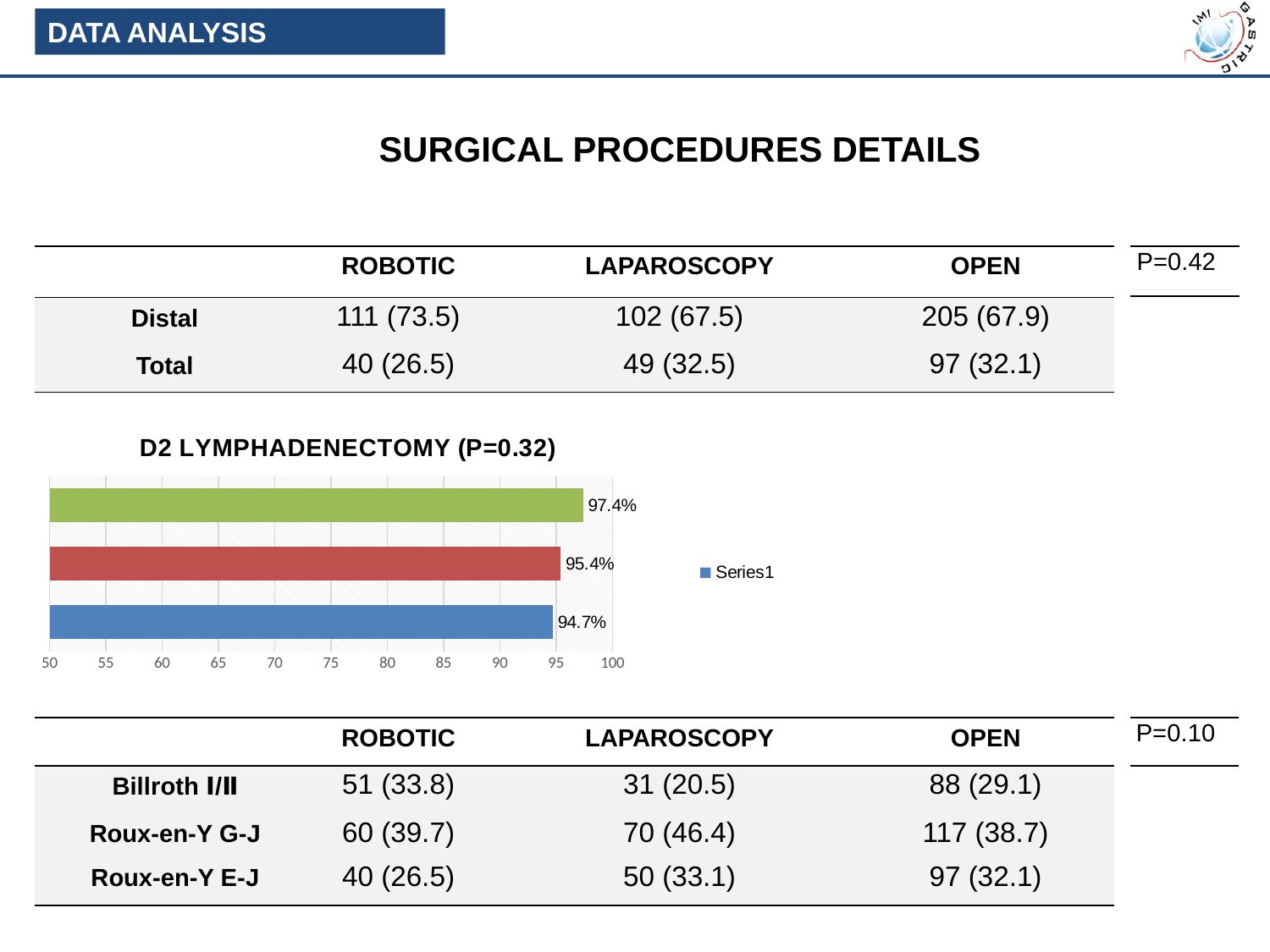
What is the name of the series shown in the legend of the D2 LYMPHADENECTOMY chart? Series1 How many bars are plotted in the D2 LYMPHADENECTOMY chart? 3 What is the value labelled on the top (green) bar of the D2 LYMPHADENECTOMY chart? 97.4% What is the title of the chart on the slide? D2 LYMPHADENECTOMY (P=0.32) Which bar in the D2 LYMPHADENECTOMY chart has the lowest value? the bottom (blue) bar What type of chart is shown under the title "D2 LYMPHADENECTOMY (P=0.32)"? bar chart In the D2 LYMPHADENECTOMY chart, is the value of the bottom (blue) bar greater or less than 90? greater Which bar in the D2 LYMPHADENECTOMY chart has the highest value? the top (green) bar How many series does the legend of the D2 LYMPHADENECTOMY chart list? 1 What is the value labelled on the middle (red) bar of the D2 LYMPHADENECTOMY chart? 95.4% In the D2 LYMPHADENECTOMY chart, what is the difference between the top bar's value and the bottom bar's value? 2.7% What is the value labelled on the bottom (blue) bar of the D2 LYMPHADENECTOMY chart? 94.7%